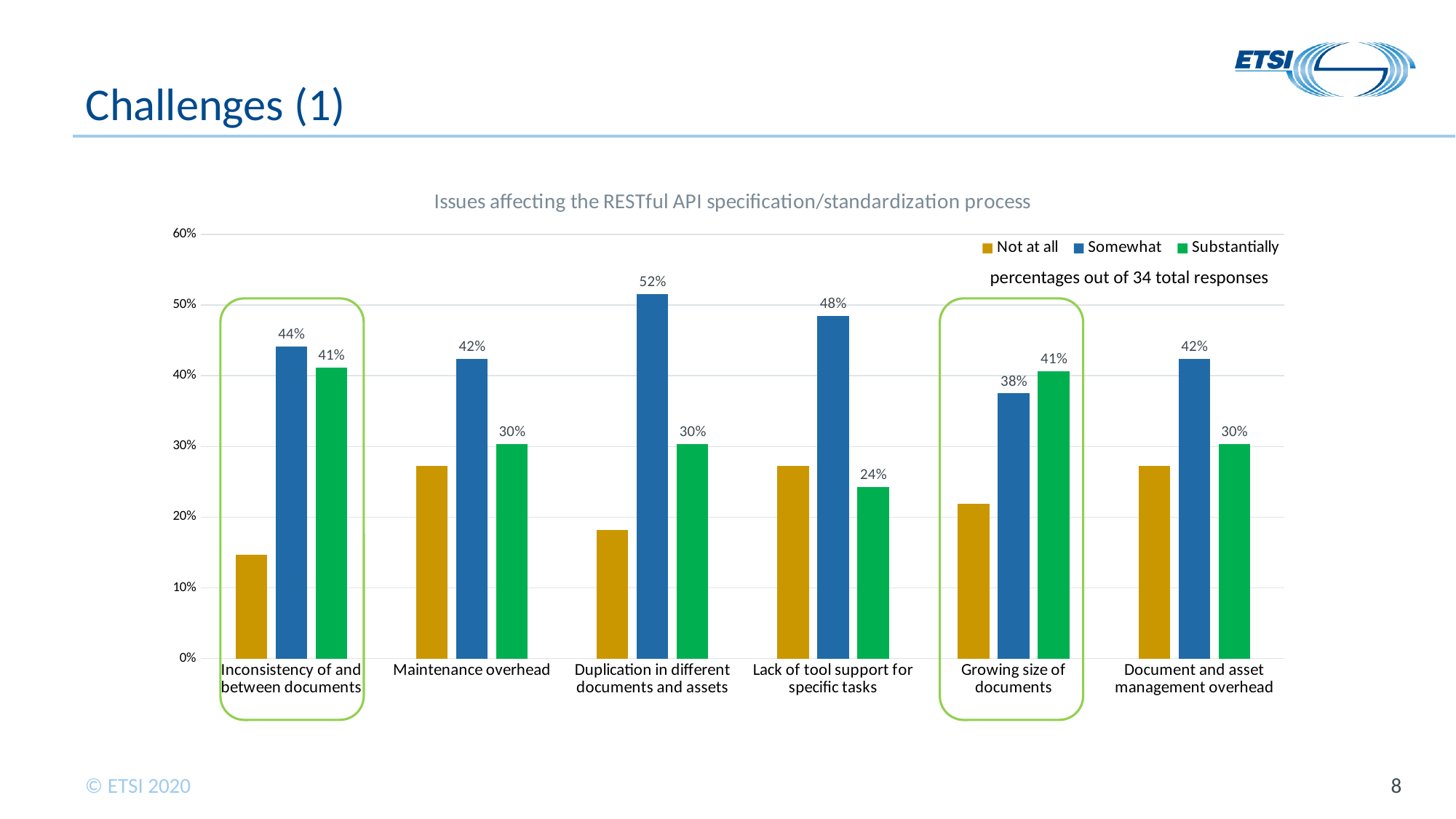
What is the 'Somewhat' value for 'Growing size of documents'? 38% How many series does the legend list? 3 For 'Growing size of documents', which is larger: the 'Somewhat' value or the 'Substantially' value? Substantially Is the 'Not at all' value for 'Inconsistency of and between documents' greater or less than 20%? less How many categories are shown on the x axis? 6 What is the 'Substantially' value for 'Lack of tool support for specific tasks'? 24% What is the difference between the 'Somewhat' and 'Substantially' values for 'Duplication in different documents and assets'? 22 percentage points What is the 'Somewhat' value for 'Duplication in different documents and assets'? 52% What is the title of the chart? Issues affecting the RESTful API specification/standardization process Which category has the highest 'Somewhat' value? Duplication in different documents and assets What kind of chart is shown on the slide? Bar chart Which category has the lowest 'Substantially' value? Lack of tool support for specific tasks